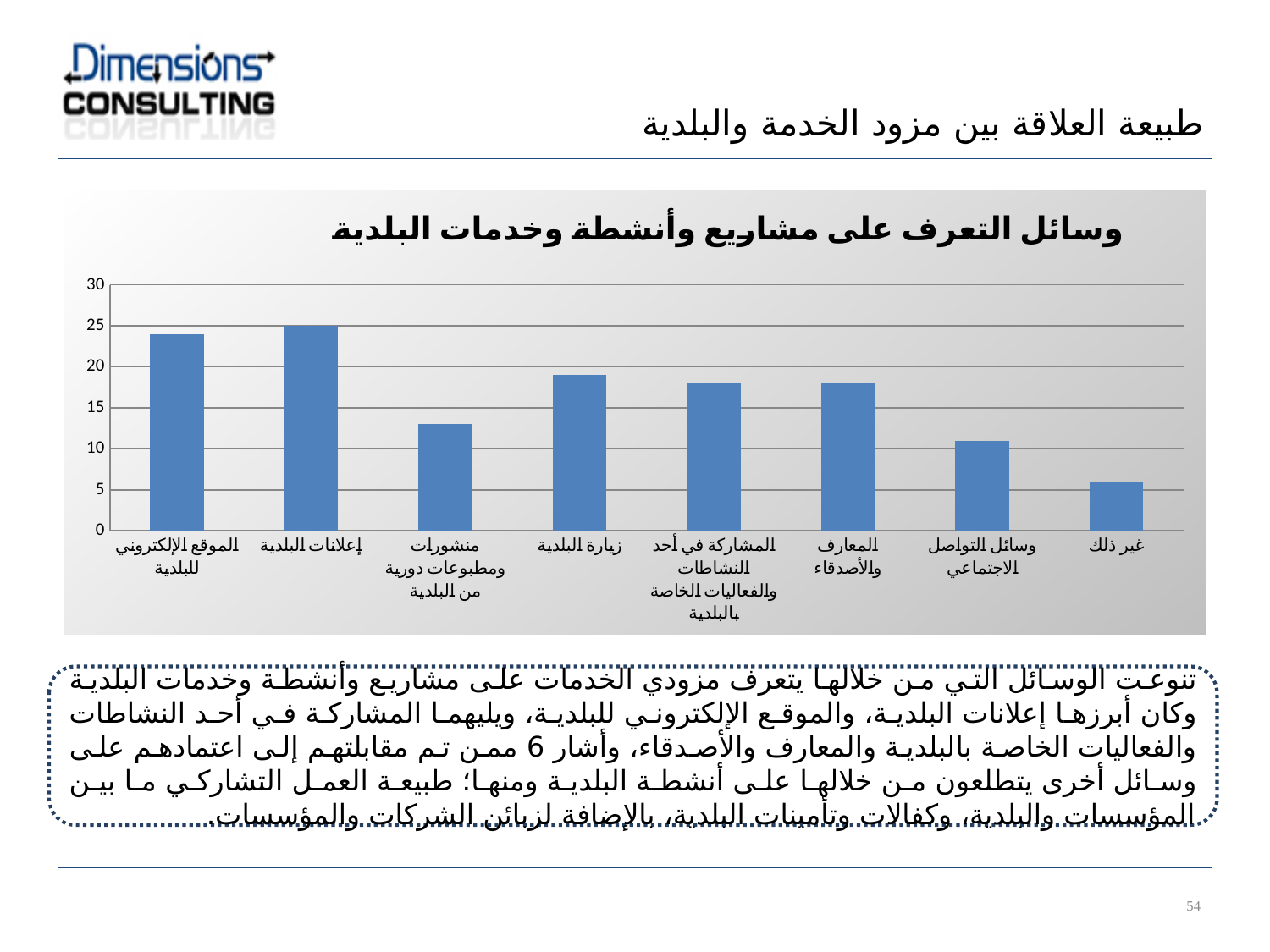
Which is larger, the value for الموقع الإلكتروني للبلدية or the value for منشورات ومطبوعات دورية من البلدية? الموقع الإلكتروني للبلدية What is the title of the chart? وسائل التعرف على مشاريع وأنشطة وخدمات البلدية Which category has the lowest bar in the chart? غير ذلك Which is larger, the value for زيارة البلدية or the value for وسائل التواصل الاجتماعي? زيارة البلدية Is the value for المعارف والأصدقاء greater or less than 20? less What is the value for إعلانات البلدية? 25 Is the value for الموقع الإلكتروني للبلدية greater or less than 20? greater How many categories are shown on the x axis of the chart? 8 Is the value for غير ذلك greater or less than 10? less Which category has the highest bar in the chart? إعلانات البلدية What kind of chart is shown on the slide? Bar chart